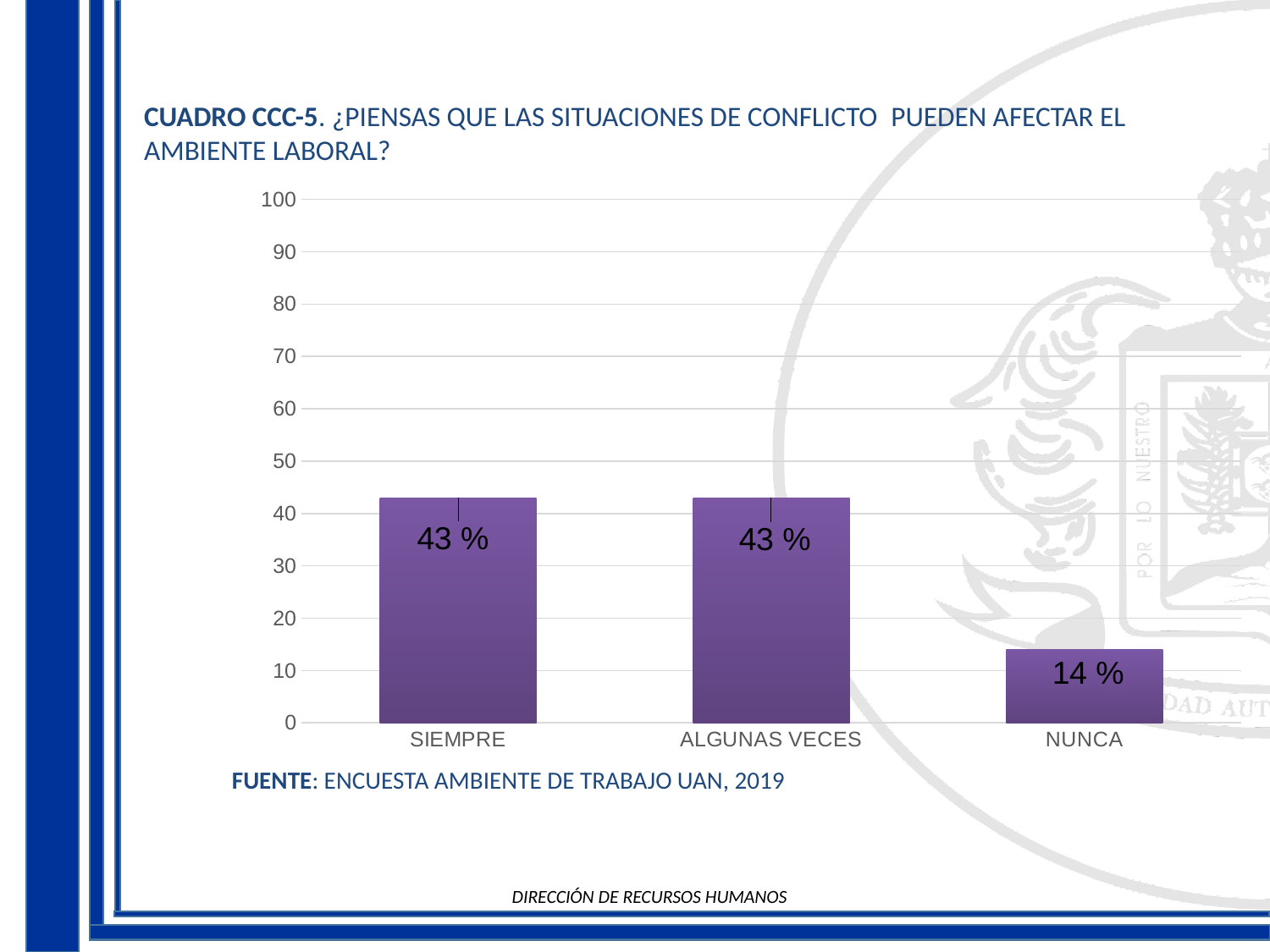
What is the highest value shown on the y axis? 100 What is the value for SIEMPRE? 43 % What is the value for NUNCA? 14 % Which is larger, the value for ALGUNAS VECES or the value for NUNCA? ALGUNAS VECES Which category has the lowest value? NUNCA What kind of chart is shown on the slide? bar chart How many categories are shown on the x axis? 3 Is the value for NUNCA greater or less than 20? less What is the value for ALGUNAS VECES? 43 % What is the difference between the values for SIEMPRE and NUNCA? 29 % Is the value for SIEMPRE greater or less than 40? greater What is the source cited below the chart? ENCUESTA AMBIENTE DE TRABAJO UAN, 2019